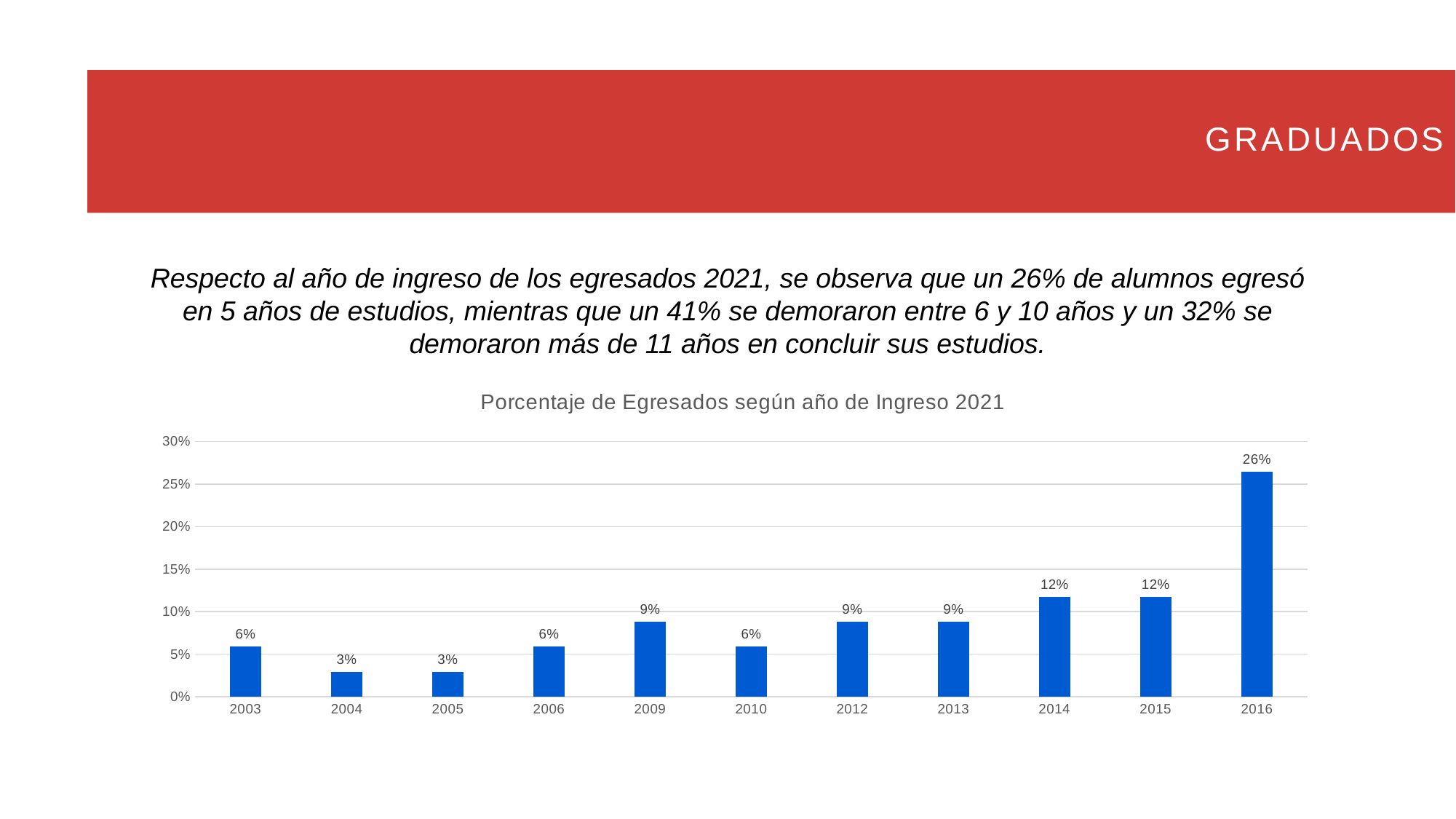
What is the title of the chart? Porcentaje de Egresados según año de Ingreso 2021 What is the difference between the values for 2016 and 2015? 14% What is the difference between the values for 2003 and 2004? 3% Is the value for 2016 greater or less than 20%? greater What is the value for 2014? 12% What is the value for 2016? 26% Which is larger, the value for 2012 or the value for 2010? 2012 What is the value for 2009? 9% How many years are shown on the x axis? 11 What kind of chart is shown? bar chart What is the value for 2004? 3% Which year has the highest percentage? 2016